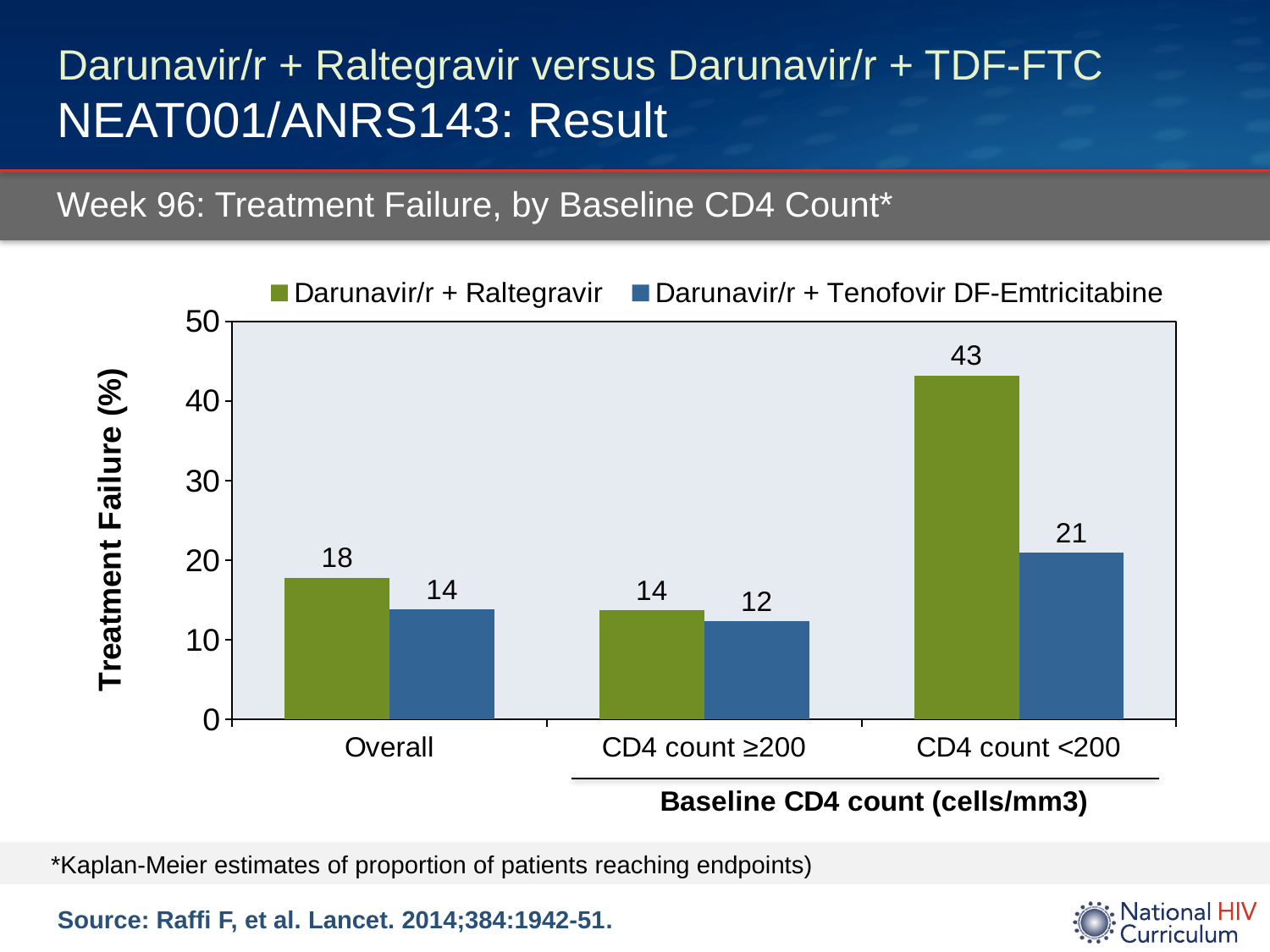
Is the treatment failure for Darunavir/r + Raltegravir in the CD4 count <200 group greater or less than 40? greater How many categories are shown on the x axis? 3 How many series does the legend list? 2 What is the difference in treatment failure between Darunavir/r + Raltegravir and Darunavir/r + Tenofovir DF-Emtricitabine in the CD4 count <200 group? 22 Which category has the lowest treatment failure for Darunavir/r + Tenofovir DF-Emtricitabine? CD4 count ≥200 What is the treatment failure percentage for Darunavir/r + Tenofovir DF-Emtricitabine in the CD4 count ≥200 group? 12 What is the treatment failure percentage for Darunavir/r + Tenofovir DF-Emtricitabine in the CD4 count <200 group? 21 Which baseline CD4 count category has the highest treatment failure for Darunavir/r + Raltegravir? CD4 count <200 What kind of chart is shown on the slide? bar chart In the Overall group, which regimen has the higher treatment failure percentage? Darunavir/r + Raltegravir What is the treatment failure percentage for Darunavir/r + Raltegravir in the Overall group? 18 What is the label of the y axis? Treatment Failure (%)